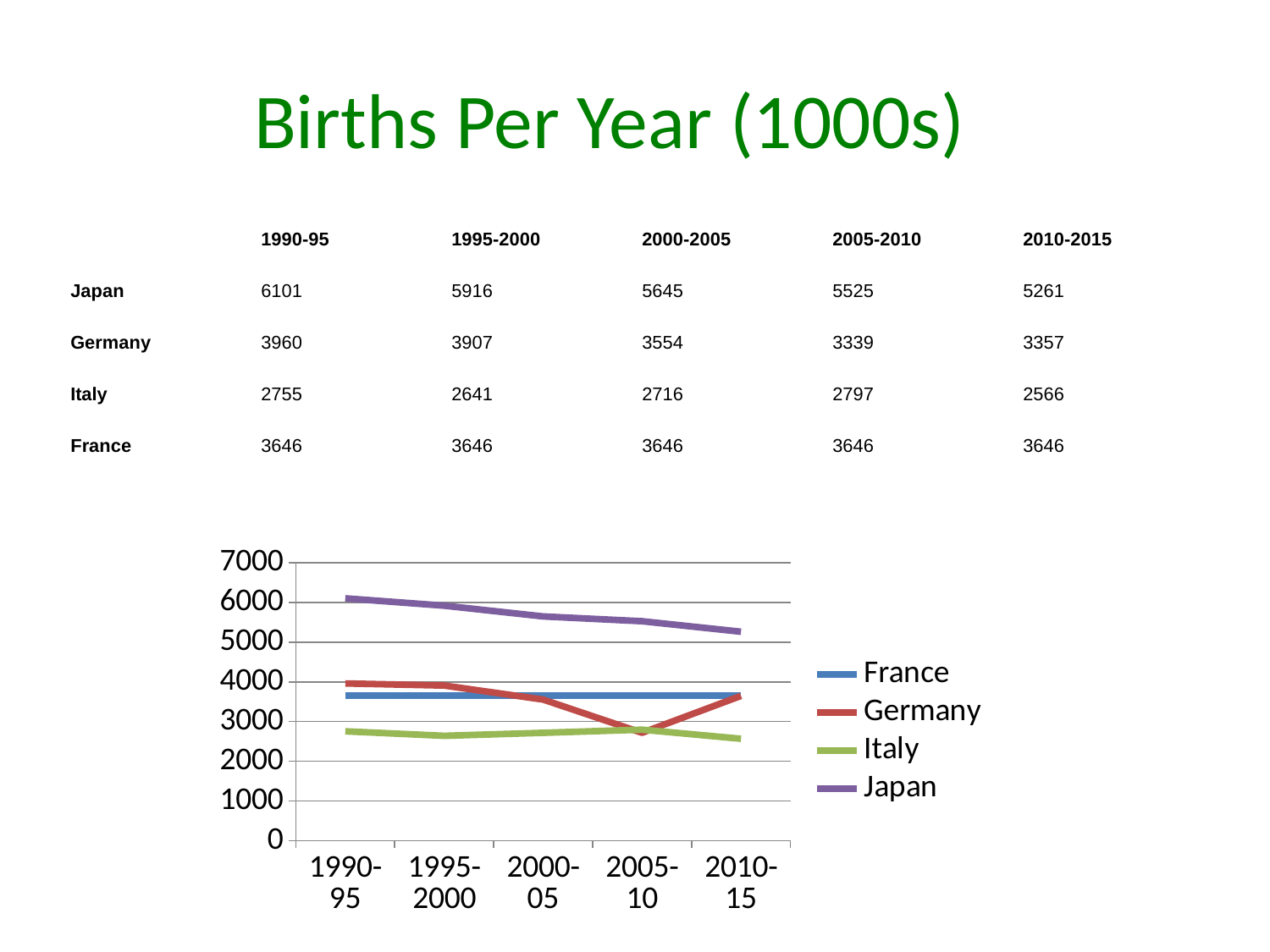
What kind of chart is shown on the slide? line chart How many series does the chart legend list? 4 Does the Japan line rise or fall across the x axis from 1990-95 to 2010-15? fall What is the difference between Japan's value in 1990-95 and its value in 2010-2015? 840 Is the value for Japan in 2010-15 greater or less than 5000? greater Which is larger in 1995-2000, the value for Germany or the value for France? Germany Which series is drawn in purple on the chart? Japan According to the slide, what is the value for Germany in 2010-2015? 3357 Which country has the highest births per year in 1990-95? Japan Which country has the lowest births per year in 2010-15? Italy According to the slide, what is the value for Japan in 2000-2005? 5645 How many time periods are plotted along the x axis of the chart? 5